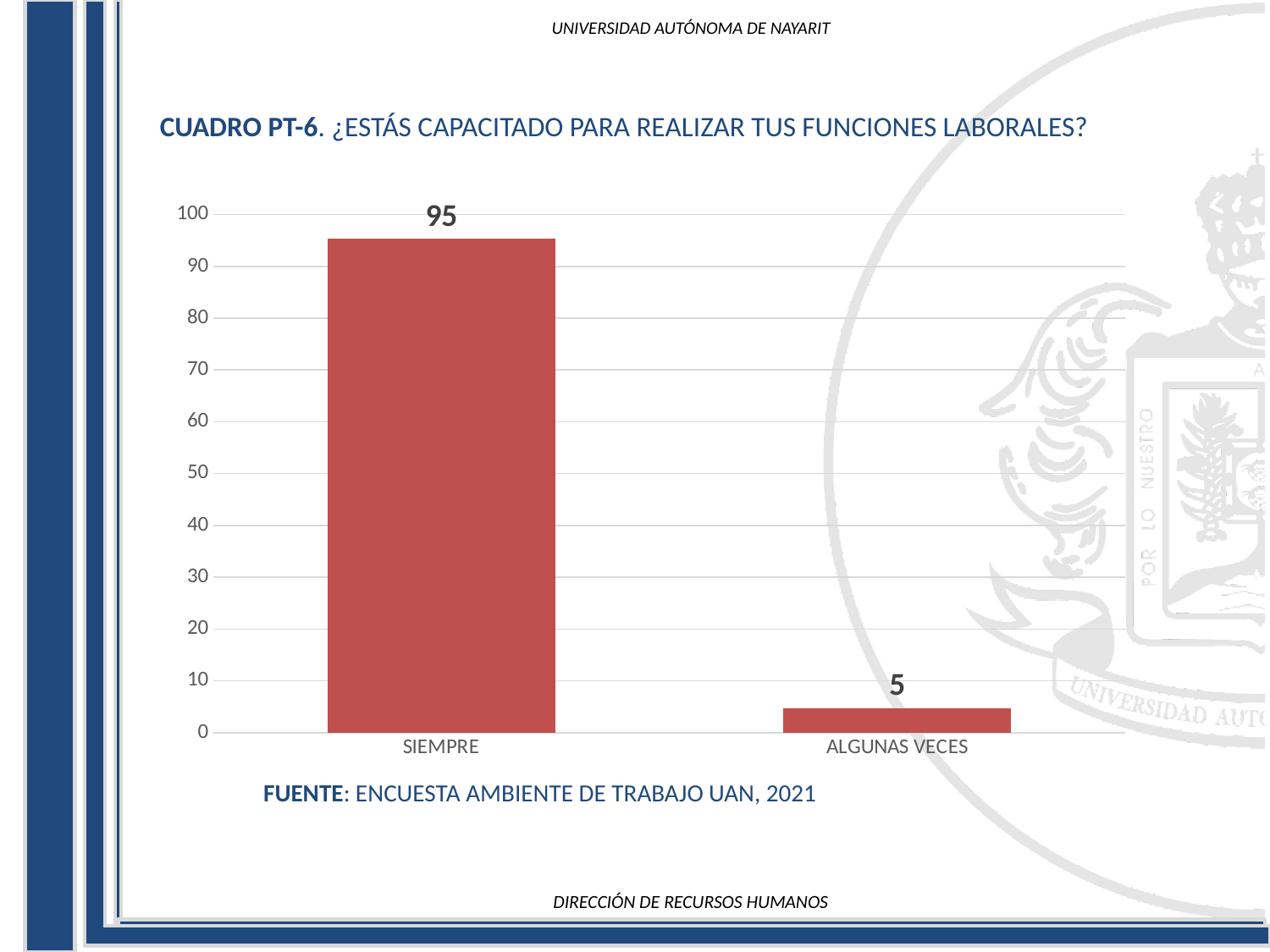
Which is larger, the value for SIEMPRE or the value for ALGUNAS VECES? SIEMPRE Is the value for ALGUNAS VECES greater or less than 10? less What is the total of the two plotted values? 100 What source is cited below the chart? ENCUESTA AMBIENTE DE TRABAJO UAN, 2021 What kind of chart is shown on the slide? bar chart Which category has the highest value? SIEMPRE What is the difference between the values for SIEMPRE and ALGUNAS VECES? 90 Is the value for SIEMPRE greater or less than 90? greater How many categories are shown on the x axis? 2 What is the value for SIEMPRE? 95 Which category has the lowest value? ALGUNAS VECES What is the value for ALGUNAS VECES? 5